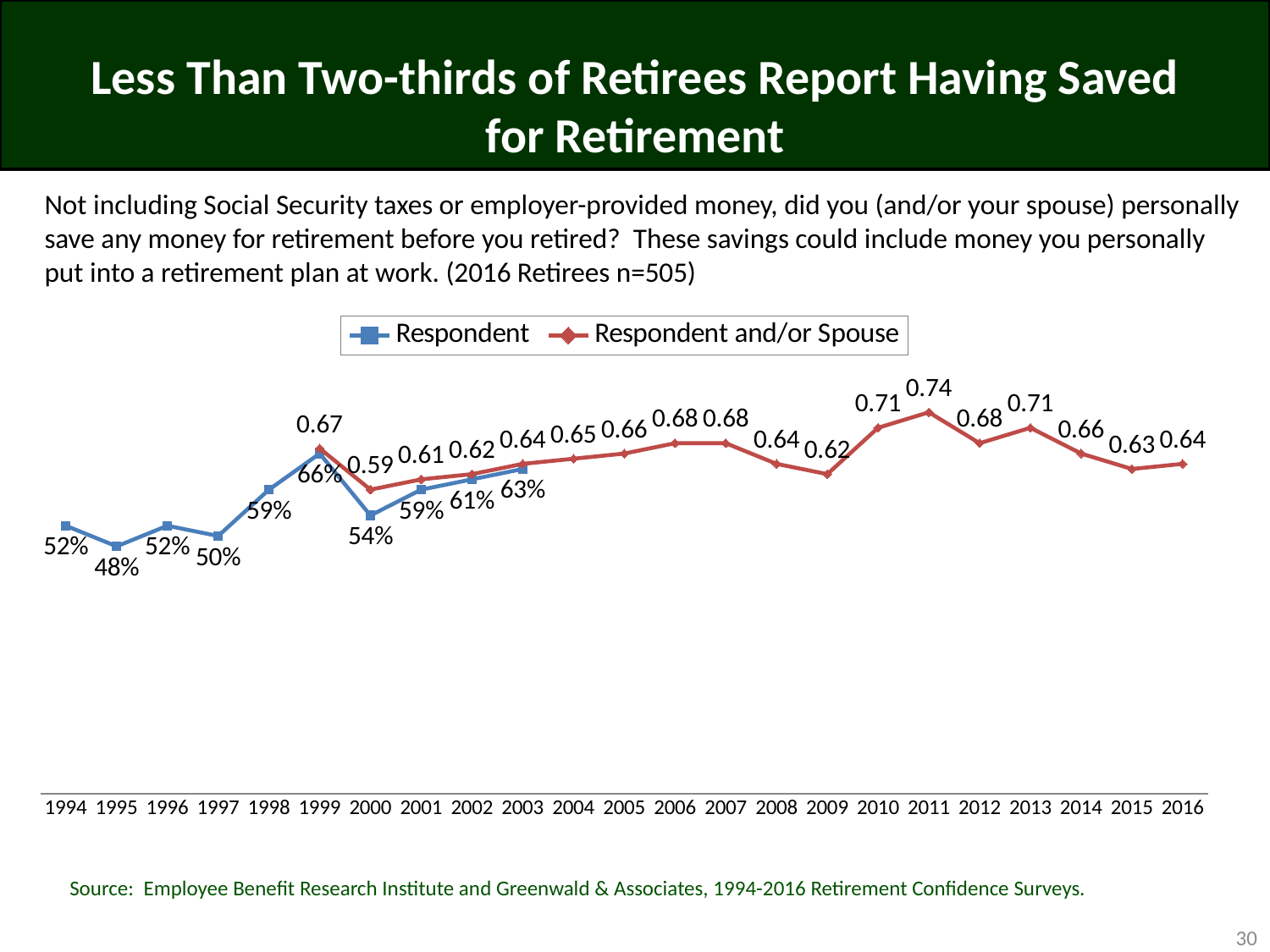
How many years are shown on the x axis? 23 What is the value for Respondent in 1995? 48% In which year does the Respondent and/or Spouse series reach its highest value? 2011 What is the value for Respondent and/or Spouse in 2016? 0.64 How many series does the legend list? 2 What kind of chart is shown on the slide? line chart Which series is drawn in red? Respondent and/or Spouse What is the difference between the Respondent and/or Spouse values for 2011 and 2016? 0.10 Which is larger, the Respondent and/or Spouse value for 2010 or for 2012? 2010 What is the difference between the Respondent values for 1999 and 1995? 18% What is the value for Respondent and/or Spouse in 2011? 0.74 In which year does the Respondent series have its lowest value? 1995